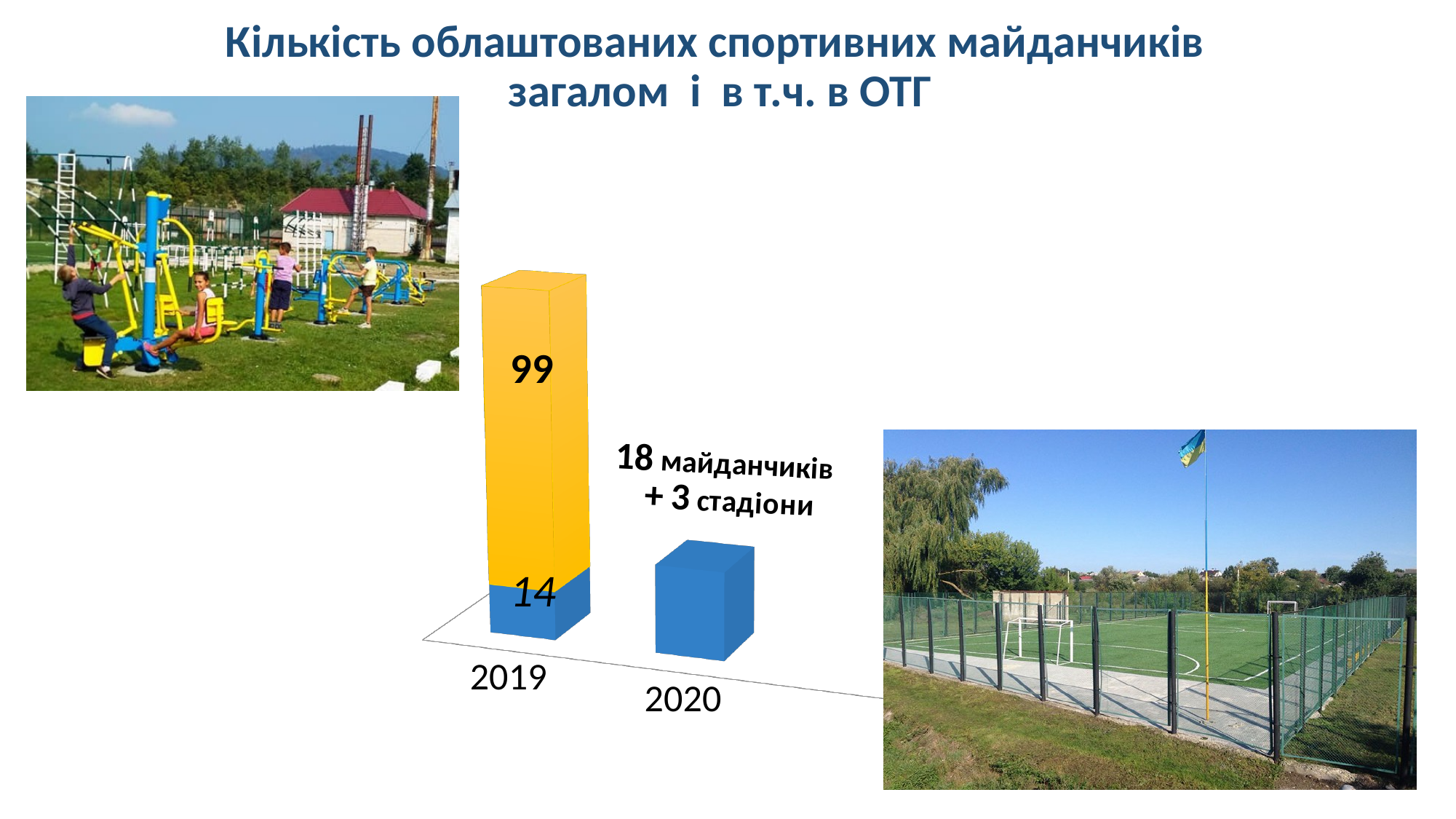
How many стадіони are mentioned in the label for 2020? 3 What kind of chart is shown on the slide? bar chart Which year has the taller bar overall, 2019 or 2020? 2019 How many years (categories) are shown on the x axis of the chart? 2 What is the title of the chart on the slide? Кількість облаштованих спортивних майданчиків загалом і в т.ч. в ОТГ What is the difference between the yellow segment value and the blue segment value of the 2019 bar? 85 What value is printed on the blue segment of the 2019 bar? 14 Which is larger, the yellow segment value (99) or the blue segment value (14) in the 2019 bar? 99 What value is printed on the yellow segment of the 2019 bar? 99 What two colours are used for the bar segments in the chart? yellow and blue What is the difference between the 18 майданчиків in 2020 and the 14 in the blue segment of 2019? 4 How many майданчиків are labelled for the 2020 bar? 18